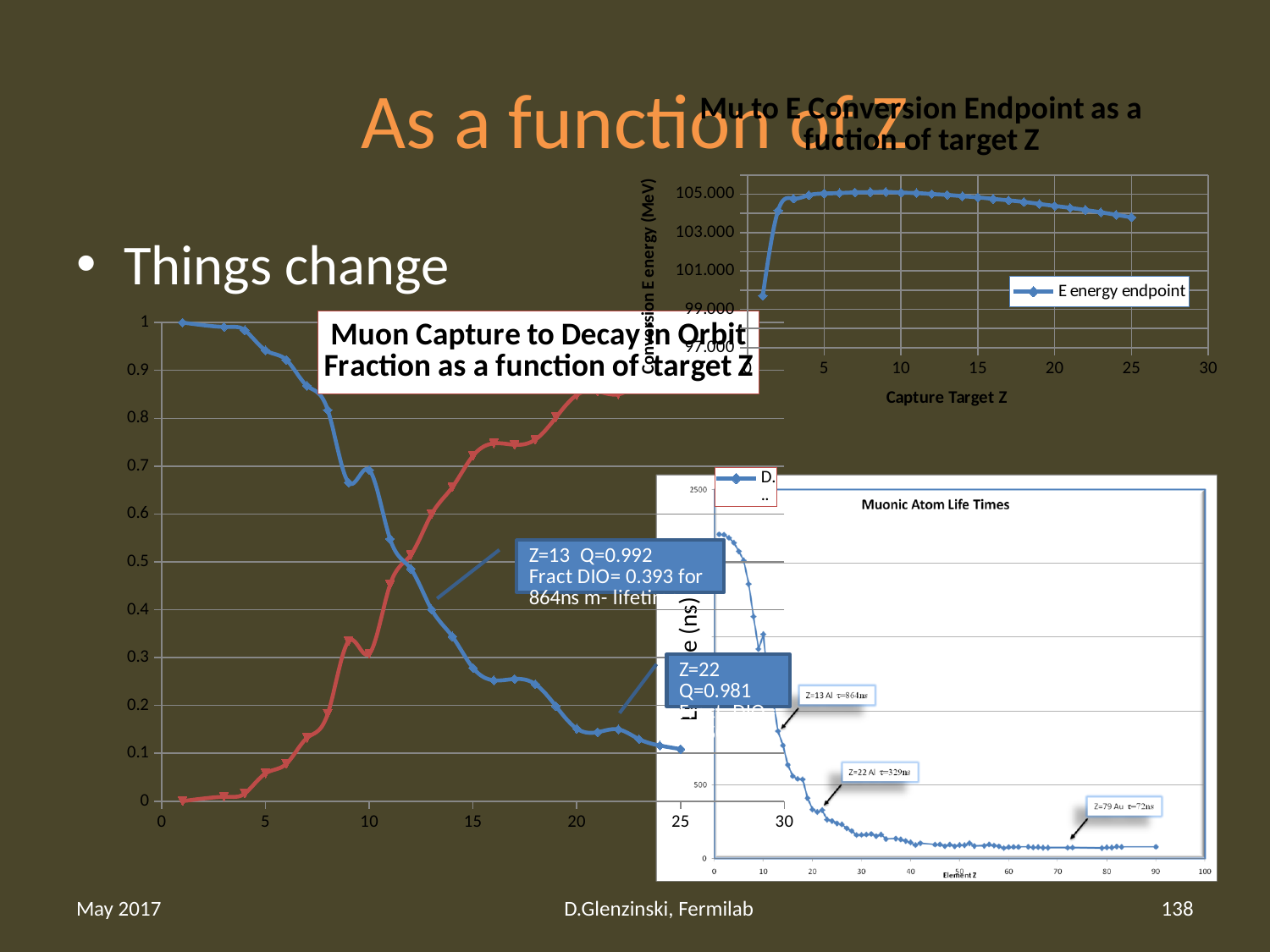
What kind of chart is the 'Muon Capture to Decay in Orbit Fraction as a function of target Z' chart? line chart In the 'Muon Capture to Decay in Orbit Fraction as a function of target Z' chart, does the blue series rise or fall as Z increases? fall In the 'Muon Capture to Decay in Orbit Fraction as a function of target Z' chart, is the blue series value at Z=5 greater or less than 0.9? greater In the 'Muon Capture to Decay in Orbit Fraction as a function of target Z' chart, is the red series value at Z=10 greater or less than 0.4? less In the 'Mu to E Conversion Endpoint as a fuction of target Z' chart, is the value at Z=1 greater or less than 101.000? less In the 'Mu to E Conversion Endpoint as a fuction of target Z' chart, what is the x-axis label? Capture Target Z In the 'Muonic Atom Life Times' chart, what lifetime is annotated for Z=79 Au? 72ns In the 'Muon Capture to Decay in Orbit Fraction as a function of target Z' chart, at Z=10 which series is larger, the blue or the red? blue In the 'Mu to E Conversion Endpoint as a fuction of target Z' chart, what series does the legend list? E energy endpoint In the 'Mu to E Conversion Endpoint as a fuction of target Z' chart, do the values rise or fall between Z=10 and Z=25? fall